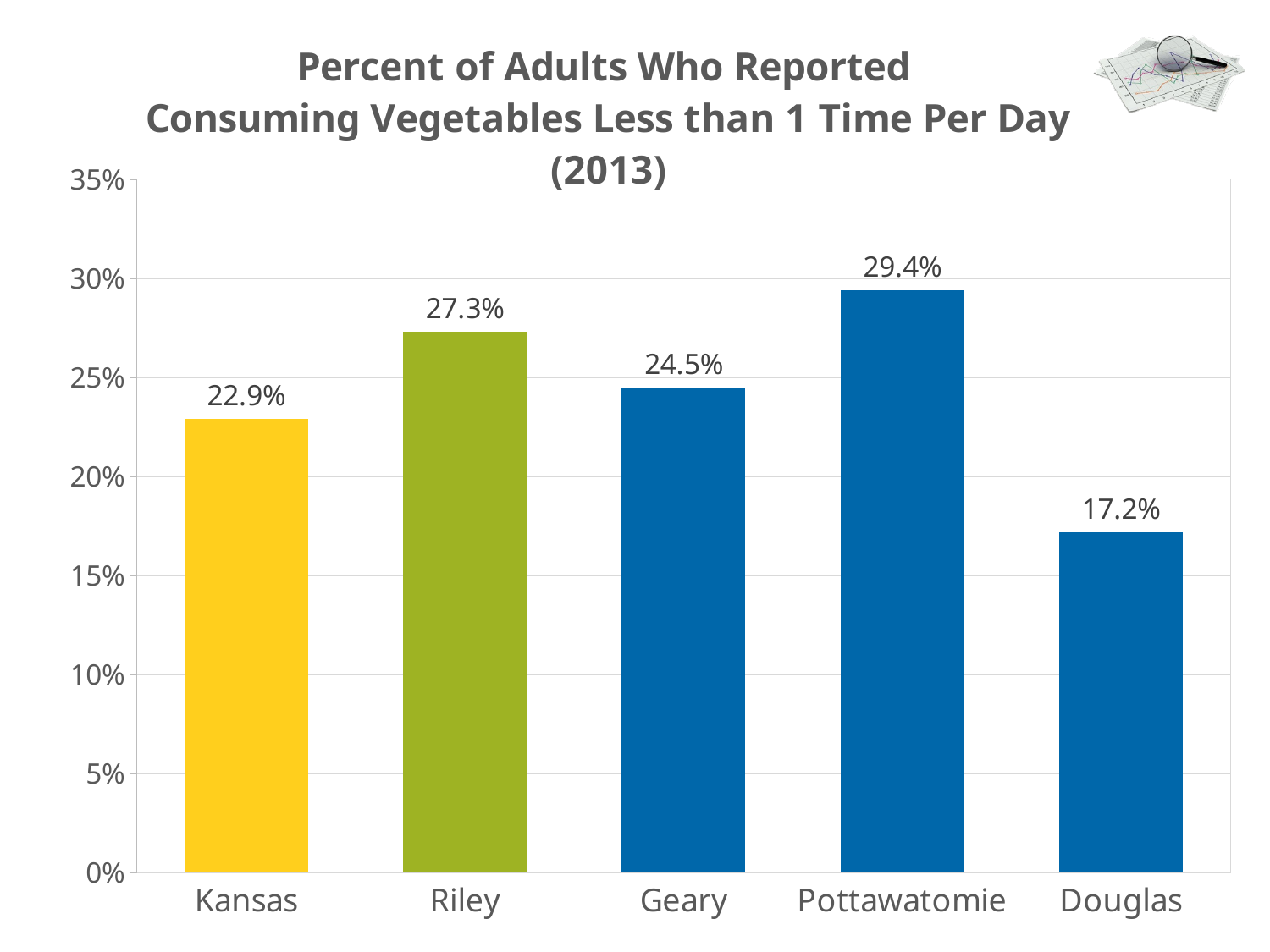
What is the value for Riley? 27.3% Which is larger, the value for Geary or the value for Riley? Riley What kind of chart is this? bar chart What is the difference between the values for Riley and Kansas? 4.4% How many categories are shown on the x axis? 5 What year is shown in the chart title? 2013 What is the difference between the values for Pottawatomie and Douglas? 12.2% What is the value for Kansas? 22.9% Which category has the highest value? Pottawatomie Which category has the lowest value? Douglas Is the value for Geary greater or less than 25%? less What is the value for Douglas? 17.2%